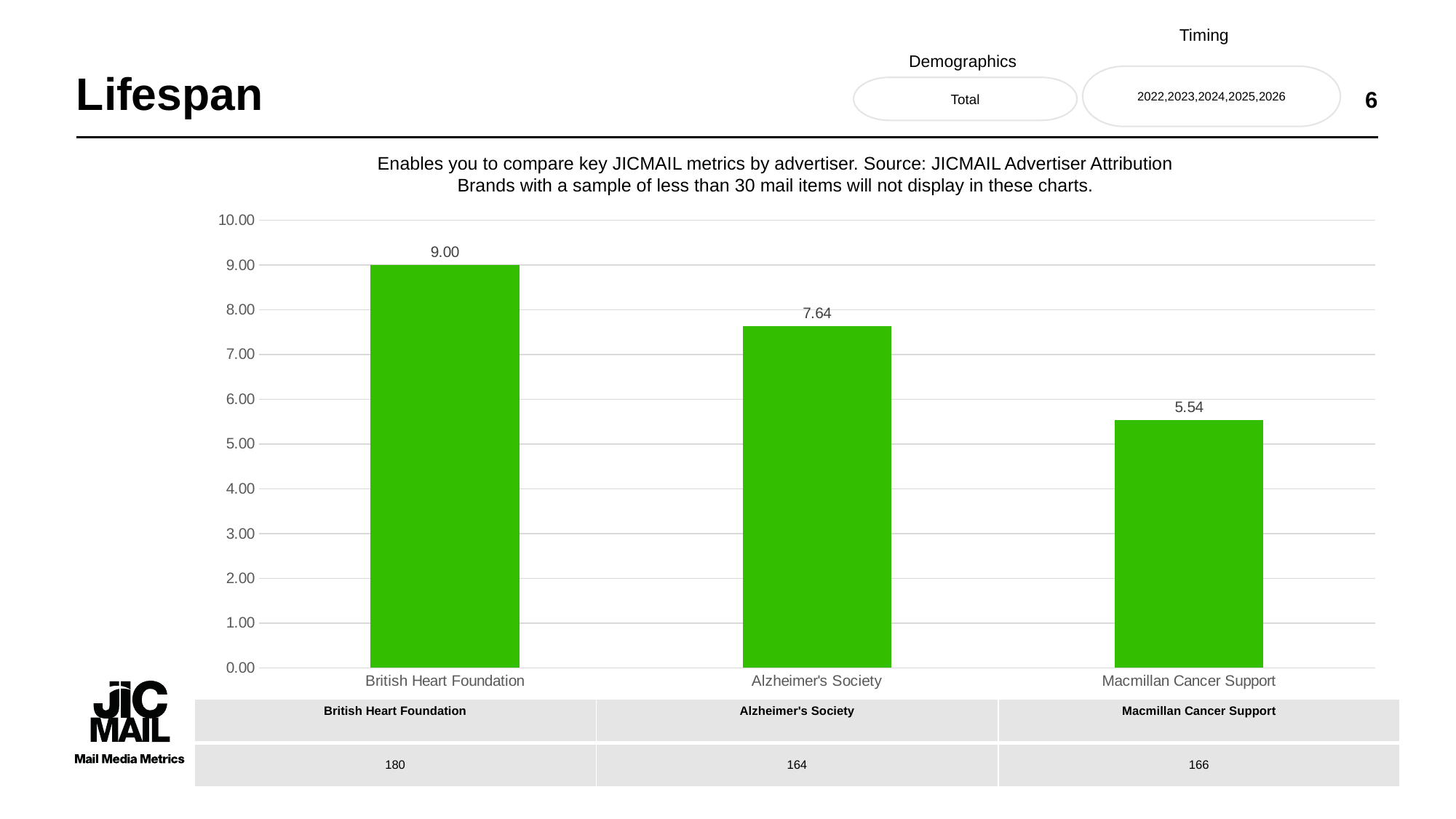
What is the Lifespan value for Alzheimer's Society? 7.64 What is the Lifespan value for British Heart Foundation? 9.00 What is the difference between the Lifespan values for Alzheimer's Society and Macmillan Cancer Support? 2.10 Do the values rise or fall from left to right across the chart? Fall What is the difference between the Lifespan values for British Heart Foundation and Alzheimer's Society? 1.36 Which advertiser has the highest Lifespan value? British Heart Foundation What kind of chart is shown on the slide? Bar chart What is the Lifespan value for Macmillan Cancer Support? 5.54 Which has a larger Lifespan value, Alzheimer's Society or Macmillan Cancer Support? Alzheimer's Society Which advertiser has the lowest Lifespan value? Macmillan Cancer Support Is the value for Macmillan Cancer Support greater or less than 6.00? less How many advertisers are shown in the chart? 3